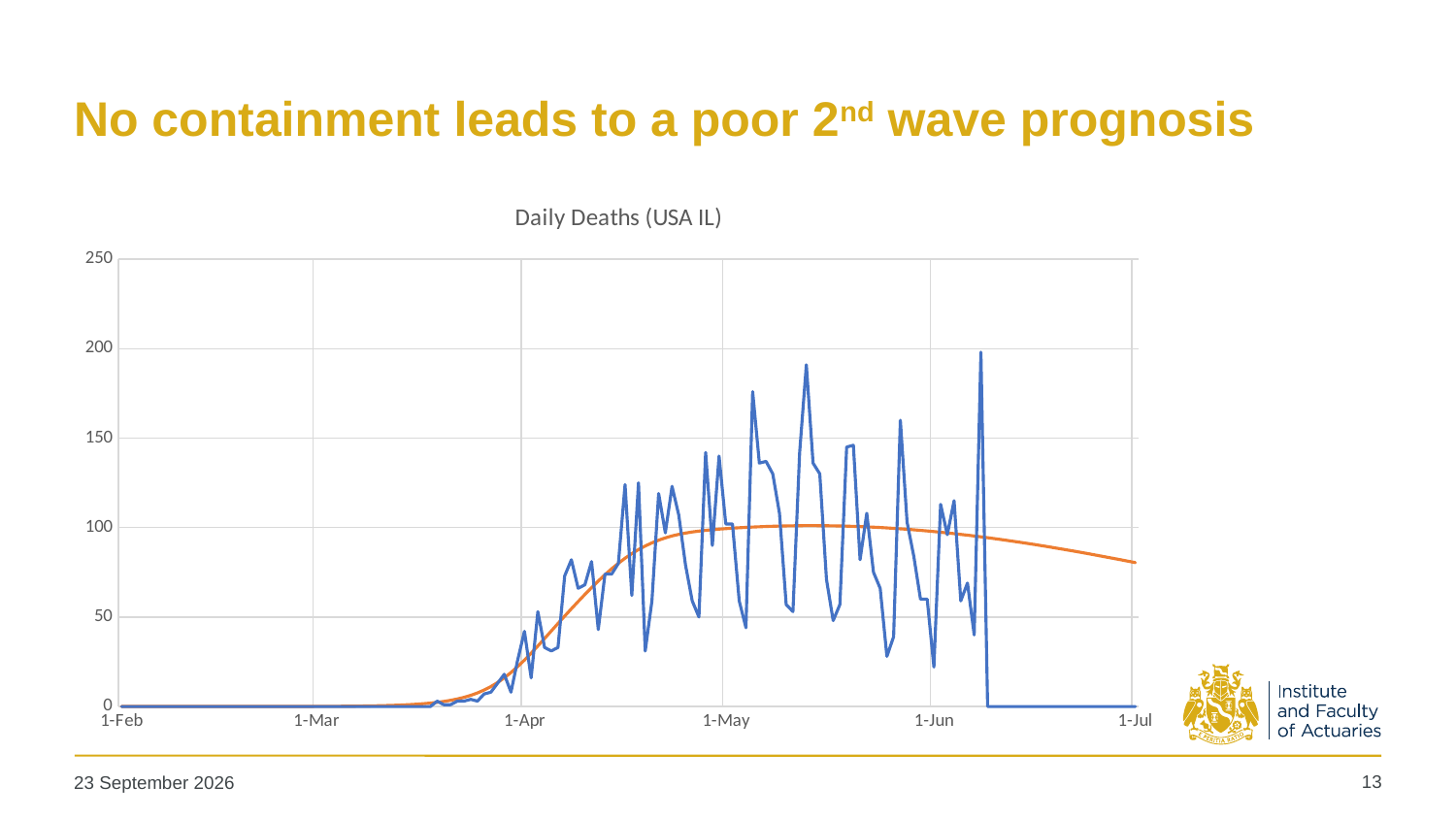
What is the highest value shown on the y axis? 250 Is the value of the orange line at 1-Jul greater or less than 100? less Which line reaches a higher peak value, the blue line or the orange line? Blue line What is the title of the chart? Daily Deaths (USA IL) Does the orange line rise or fall between 1-Jun and 1-Jul? Fall How many lines are plotted on the chart? 2 What type of chart is shown on the slide? Line chart What is the value of the blue line at 1-Feb? 0 Does the orange line rise or fall between 1-Mar and 1-Apr? Rise Is the highest peak of the blue line greater or less than 150? greater How many date labels are shown on the x axis? 6 Is the value of the orange line at 1-Apr greater or less than 50? less